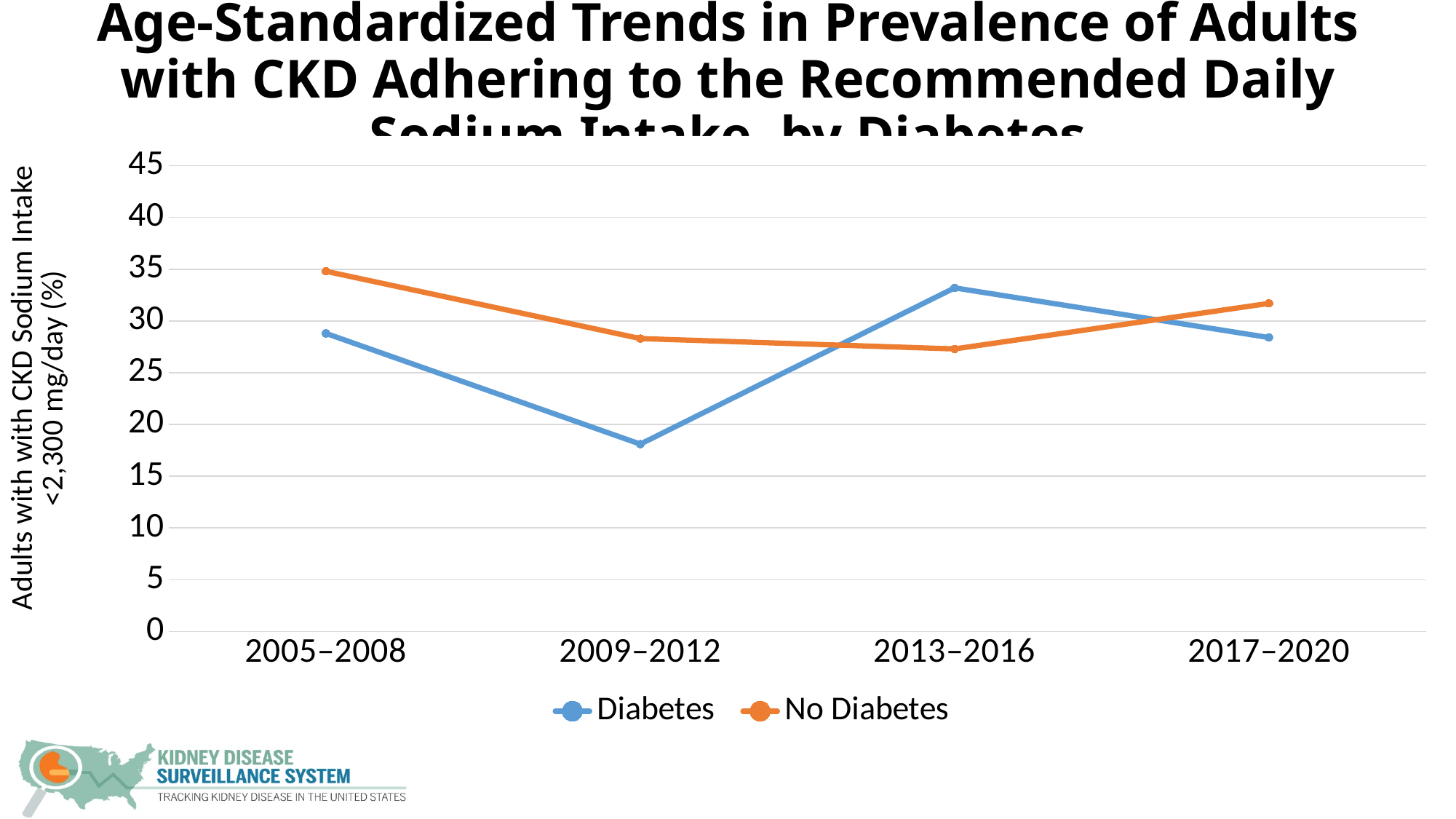
In 2013–2016, which series has the higher value, Diabetes or No Diabetes? Diabetes Which series is shown in orange? No Diabetes How many time periods are shown on the x axis? 4 Is the value for Diabetes in 2009–2012 greater or less than 20? less In which period is the Diabetes series at its highest? 2013–2016 In which period is the Diabetes series at its lowest? 2009–2012 In which period is the No Diabetes series at its highest? 2005–2008 Is the value for No Diabetes in 2013–2016 greater or less than 30? less How many series does the legend list? 2 What kind of chart is shown on the slide? Line chart Does the No Diabetes series rise or fall from 2005–2008 to 2009–2012? Fall Is the value for Diabetes in 2013–2016 greater or less than 30? greater